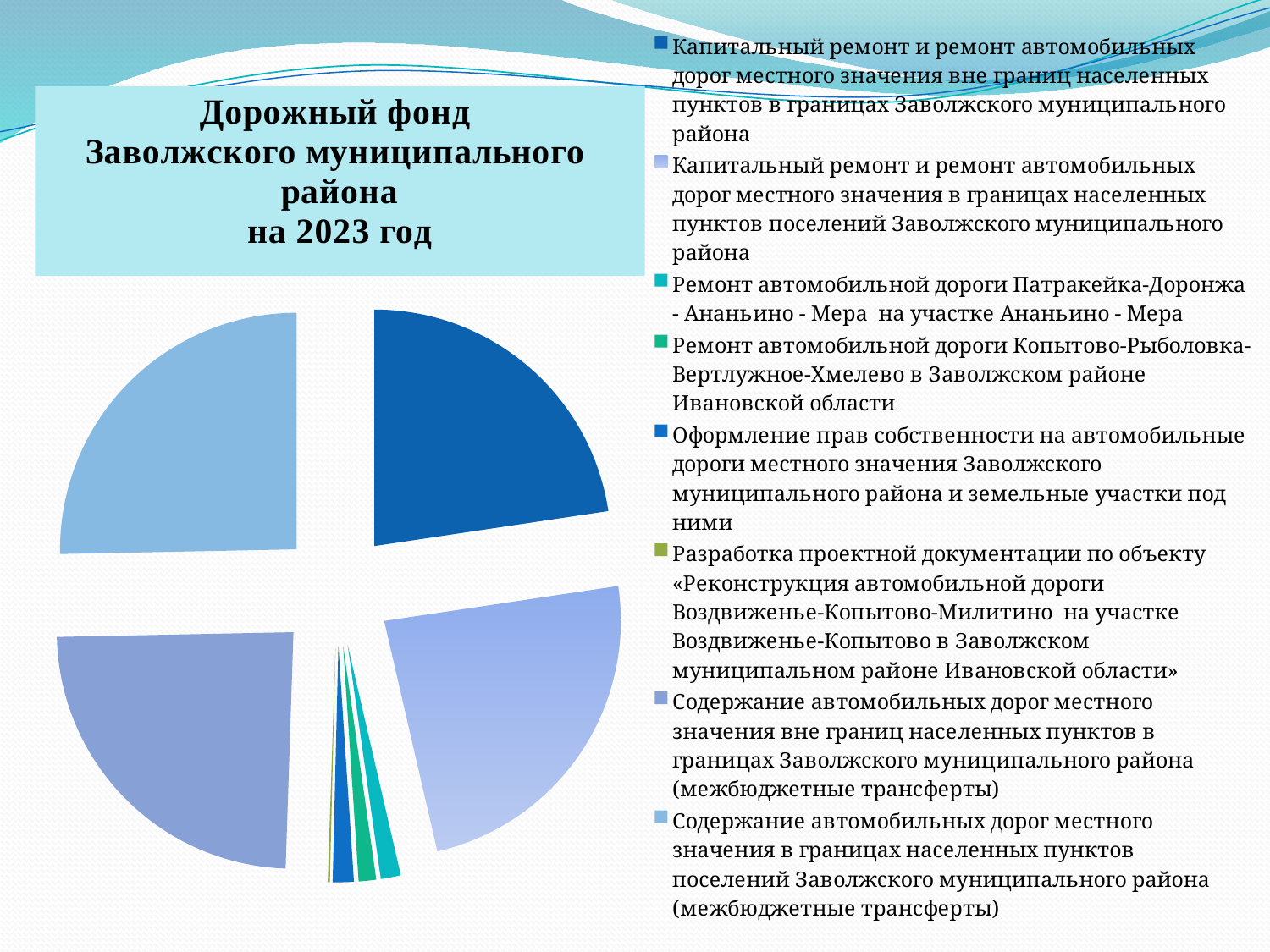
Which slice is larger: «Капитальный ремонт и ремонт автомобильных дорог местного значения в границах населенных пунктов поселений Заволжского муниципального района» or «Ремонт автомобильной дороги Патракейка-Доронжа - Ананьино - Мера на участке Ананьино - Мера»? Капитальный ремонт и ремонт автомобильных дорог местного значения в границах населенных пунктов поселений Заволжского муниципального района Which legend entry is listed first in the chart's legend? Капитальный ремонт и ремонт автомобильных дорог местного значения вне границ населенных пунктов в границах Заволжского муниципального района Which slice is larger: «Содержание автомобильных дорог местного значения вне границ населенных пунктов в границах Заволжского муниципального района (межбюджетные трансферты)» or «Оформление прав собственности на автомобильные дороги местного значения Заволжского муниципального района и земельные участки под ними»? Содержание автомобильных дорог местного значения вне границ населенных пунктов в границах Заволжского муниципального района (межбюджетные трансферты) How many entries does the chart's legend list? 8 Which category has the smallest slice in the pie chart? Разработка проектной документации по объекту «Реконструкция автомобильной дороги Воздвиженье-Копытово-Милитино на участке Воздвиженье-Копытово в Заволжском муниципальном районе Ивановской области» What is the title of the chart on the slide? Дорожный фонд Заволжского муниципального района на 2023 год How many slices does the pie chart have? 8 What kind of chart is shown on the slide? pie chart